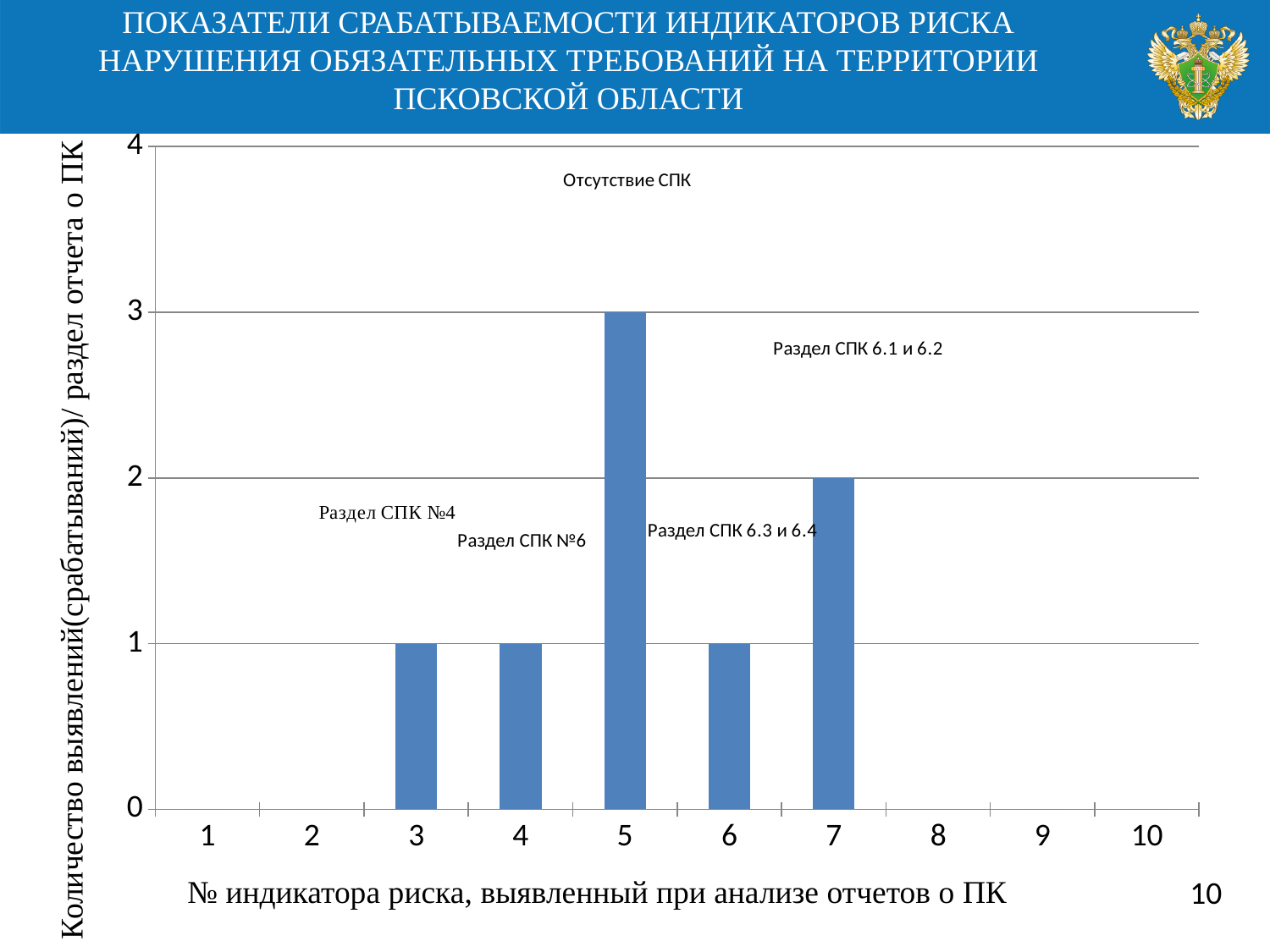
What is the value for risk indicator number 5? 3 What is the total of the values for indicators 3, 4, 5, 6 and 7? 8 Which is larger, the value for indicator 7 or the value for indicator 4? indicator 7 What is the difference between the values for indicator 5 and indicator 7? 1 What type of chart is shown on the slide? bar chart What is the value for risk indicator number 3? 1 How many risk indicators have a visible bar (a value above 0)? 5 What label is written above the tallest bar? Отсутствие СПК What is the value for risk indicator number 6? 1 Which risk indicator number has the highest value? 5 How many risk indicator numbers are shown on the x axis? 10 What is the value for risk indicator number 7? 2